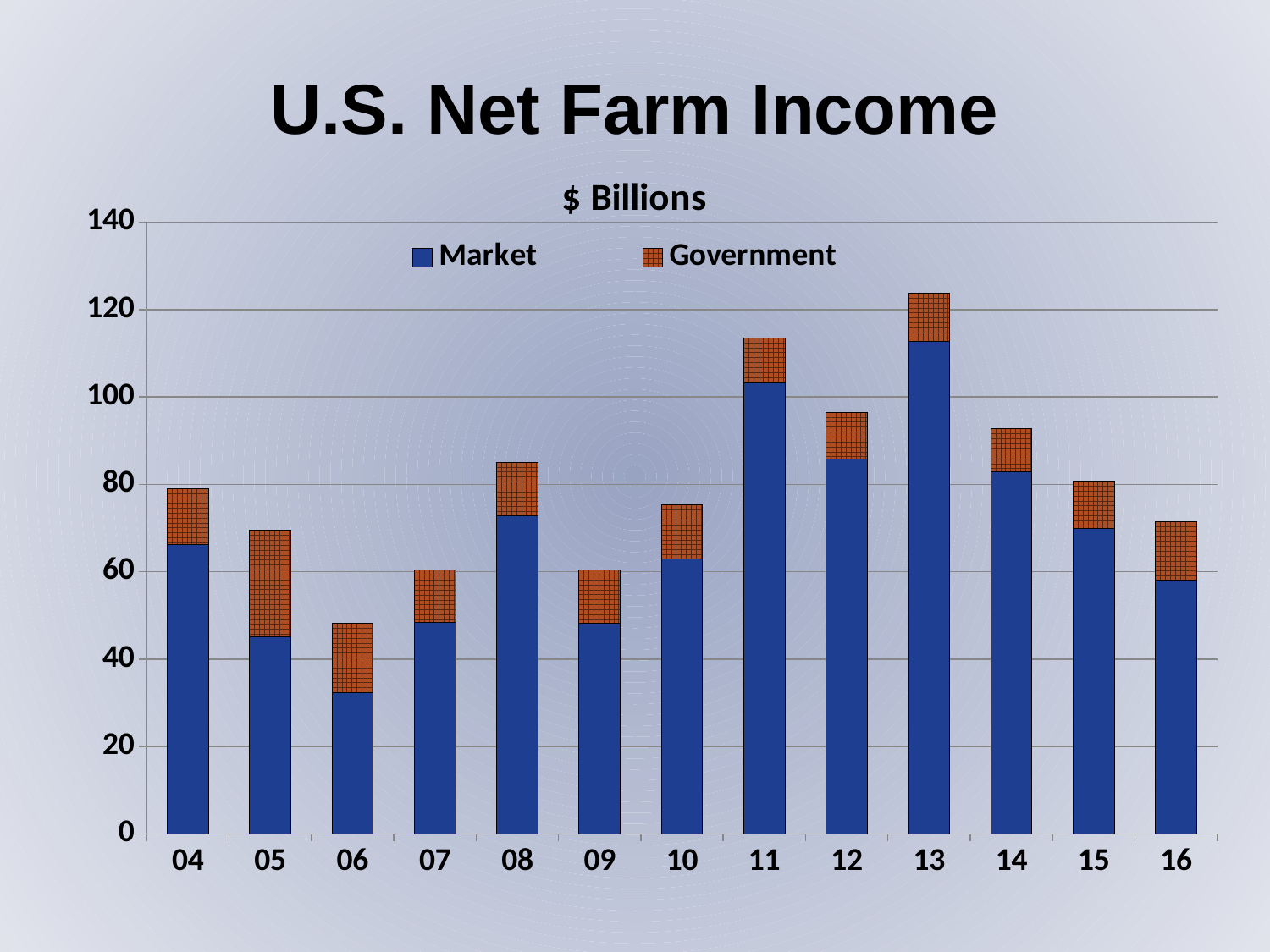
What unit is shown above the chart? $ Billions Is the total bar for 13 greater or less than 120? greater Which year has the larger total bar, 11 or 12? 11 Is the Market value for 11 greater or less than 100? greater How many years are shown on the x axis? 13 Which year has the lowest total net farm income? 06 How many series does the legend list? 2 Do the total bars rise or fall from 13 to 16? fall Which year has the highest total net farm income? 13 Is the total bar for 06 greater or less than 60? less Which year has the largest Government segment? 05 What kind of chart is shown on the slide? bar chart